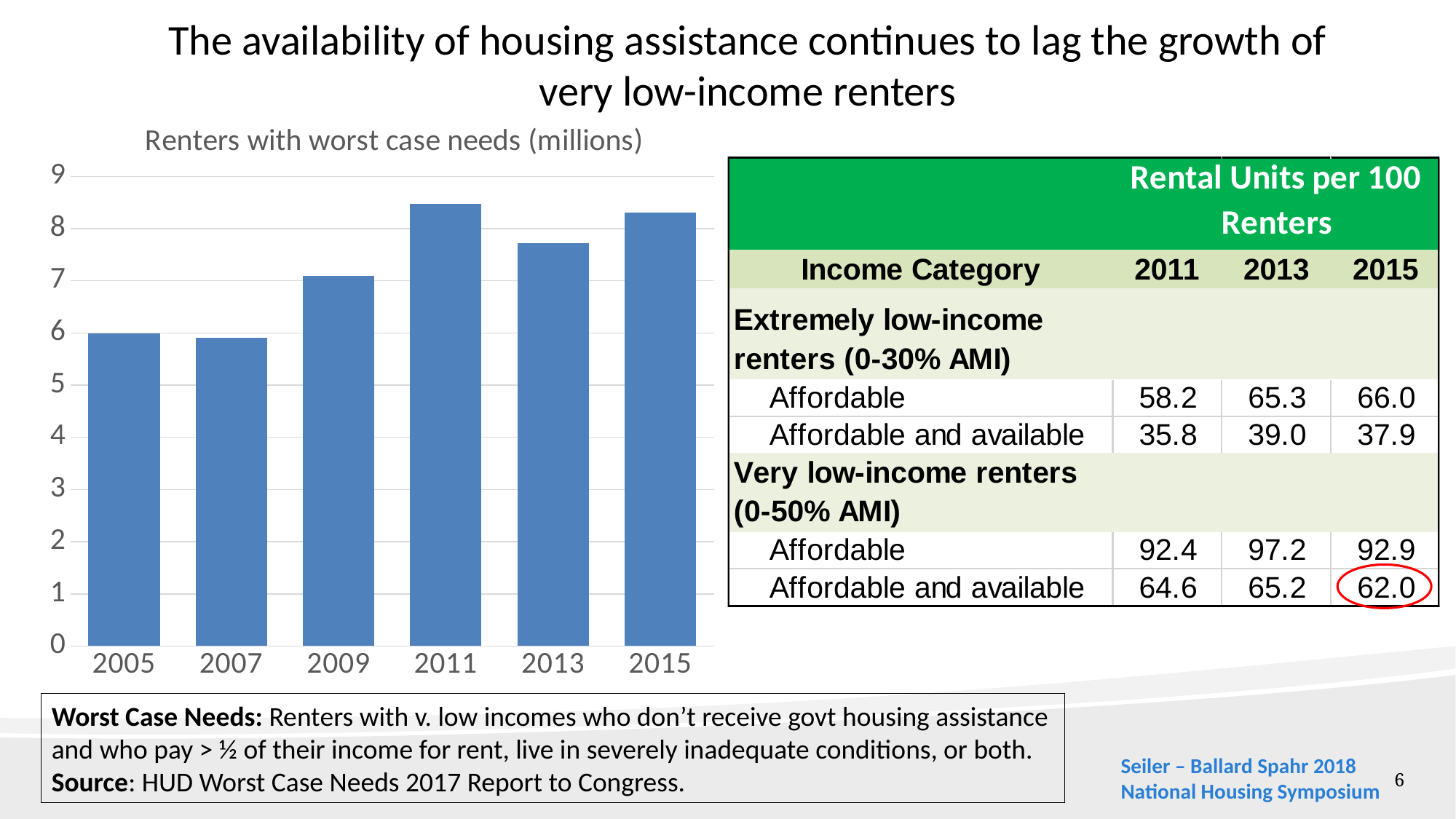
Overall, do the values in the bar chart rise or fall from 2005 to 2015? rise Is the value for 2015 in the bar chart greater or less than 8? greater Which year has the highest number of renters with worst case needs in the bar chart? 2011 Is the value for 2009 in the bar chart greater or less than 8? less What is the title of the bar chart? Renters with worst case needs (millions) Is the value for 2011 in the bar chart greater or less than 8? greater In the bar chart, which year has a larger value, 2011 or 2013? 2011 What kind of chart is shown on the slide? bar chart In the bar chart, which year has a larger value, 2009 or 2013? 2013 How many years are shown on the x axis of the bar chart? 6